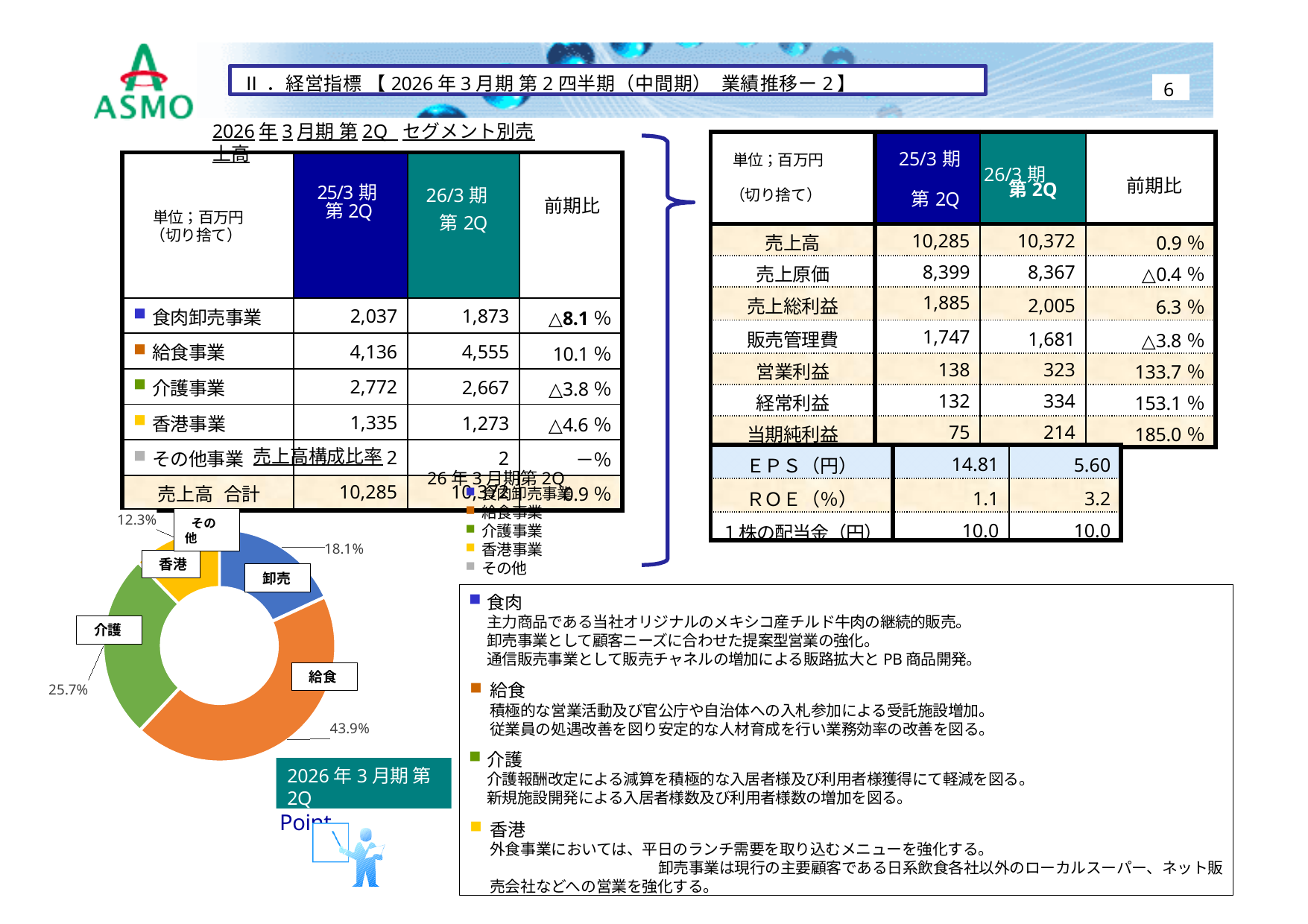
In the pie chart, which slice is larger, 介護 or 卸売? 介護 How many entries does the pie chart's legend list? 5 In the pie chart, what share is shown for 香港? 12.3% In the pie chart, what share is shown for 介護? 25.7% Which segment has the smallest slice in the pie chart? 香港 In the pie chart, how many percentage points larger is the 給食 share than the 介護 share? 18.2 In the pie chart, what share is shown for 卸売? 18.1% What colour is the 給食 slice in the pie chart? orange Which segment has the largest slice in the pie chart? 給食 What kind of chart is shown at the bottom left of the slide? doughnut chart In the pie chart, what share is shown for 給食? 43.9% How many slices does the pie chart have? 4